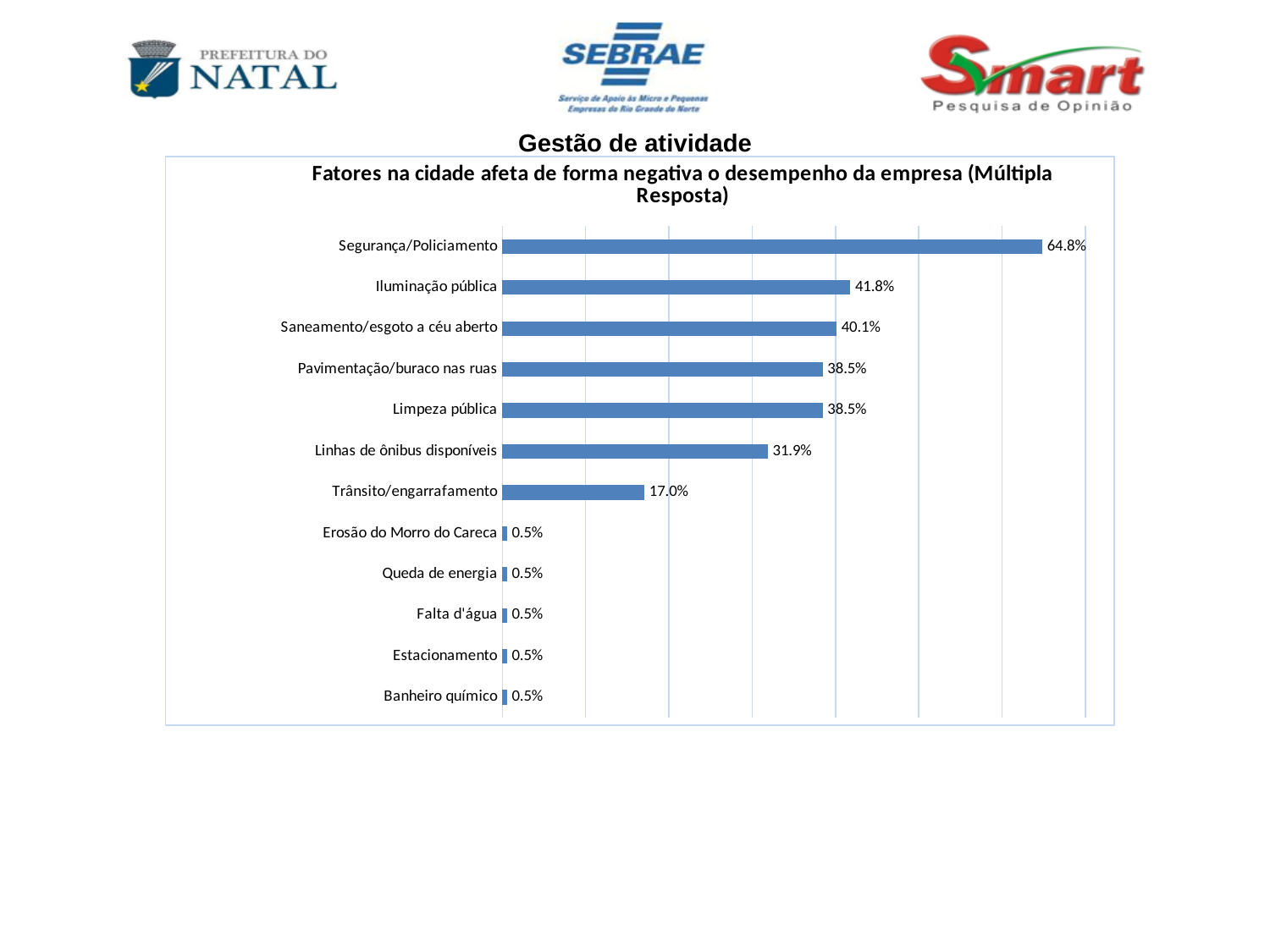
How many categories have a value of 0.5%? 5 What is the value for Iluminação pública? 41.8% What kind of chart is shown on the slide? Bar chart What is the difference between Saneamento/esgoto a céu aberto and Trânsito/engarrafamento? 23.1% What is the title of the chart? Fatores na cidade afeta de forma negativa o desempenho da empresa (Múltipla Resposta) Which is larger, Iluminação pública or Linhas de ônibus disponíveis? Iluminação pública What is the difference between Segurança/Policiamento and Iluminação pública? 23.0% What is the value for Trânsito/engarrafamento? 17.0% How many categories are shown in the chart? 12 What is the value for Linhas de ônibus disponíveis? 31.9% What is the value for Segurança/Policiamento? 64.8% Which category has the highest value? Segurança/Policiamento